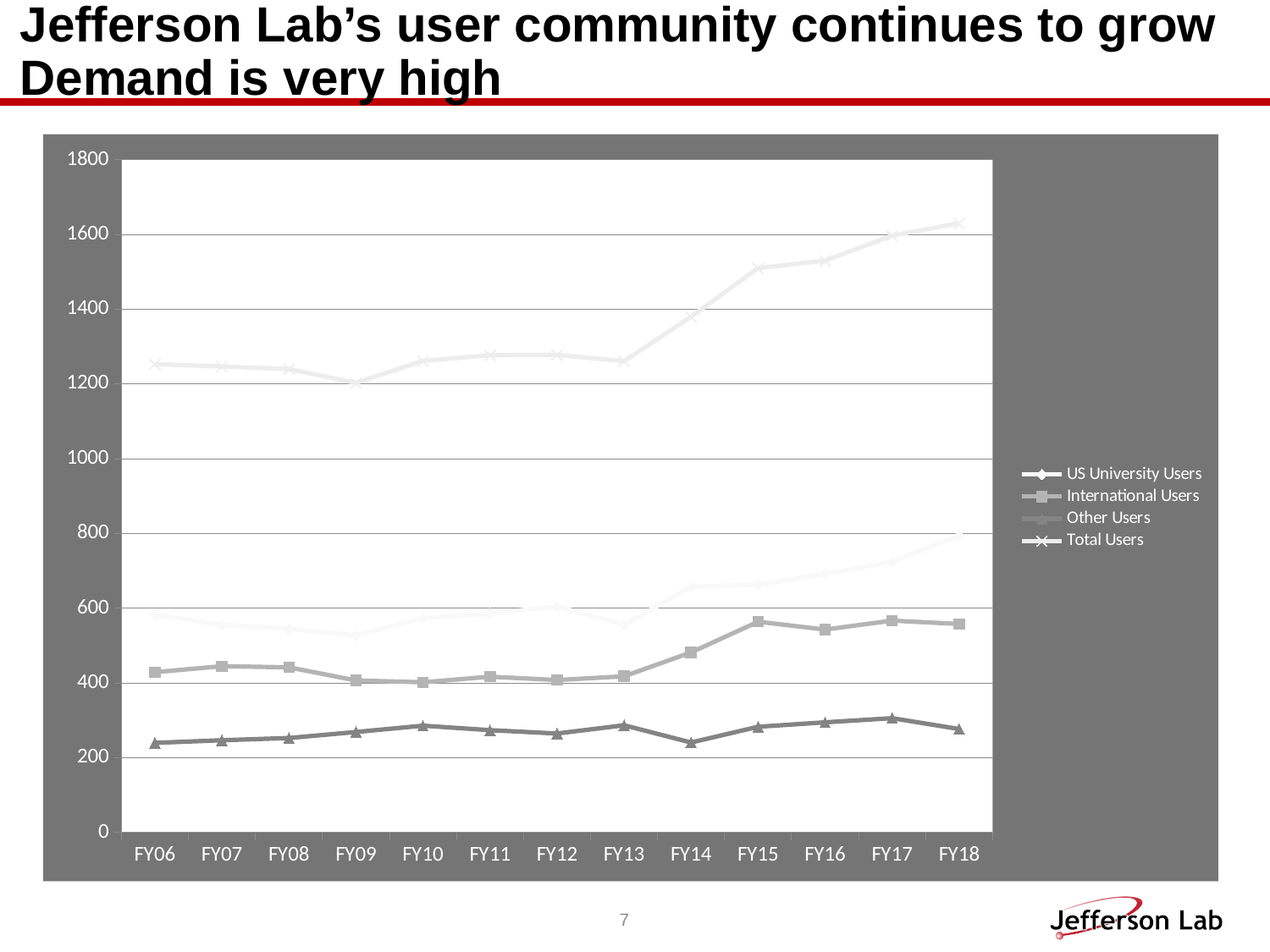
Which fiscal year has the lowest value for Total Users? FY09 Is the value for Other Users in FY14 greater or less than 600? less How many series does the legend list? 4 Which series in the legend is drawn with x-shaped markers? Total Users Is the value for US University Users in FY17 greater or less than 400? greater How many fiscal years are plotted along the x axis? 13 Do the values for Total Users rise or fall from FY13 to FY18? Rise In FY18, which is larger: International Users or US University Users? US University Users Which fiscal year has the highest value for Total Users? FY18 What kind of chart is shown on the slide? Line chart Is the value for Total Users in FY15 greater or less than 1400? greater